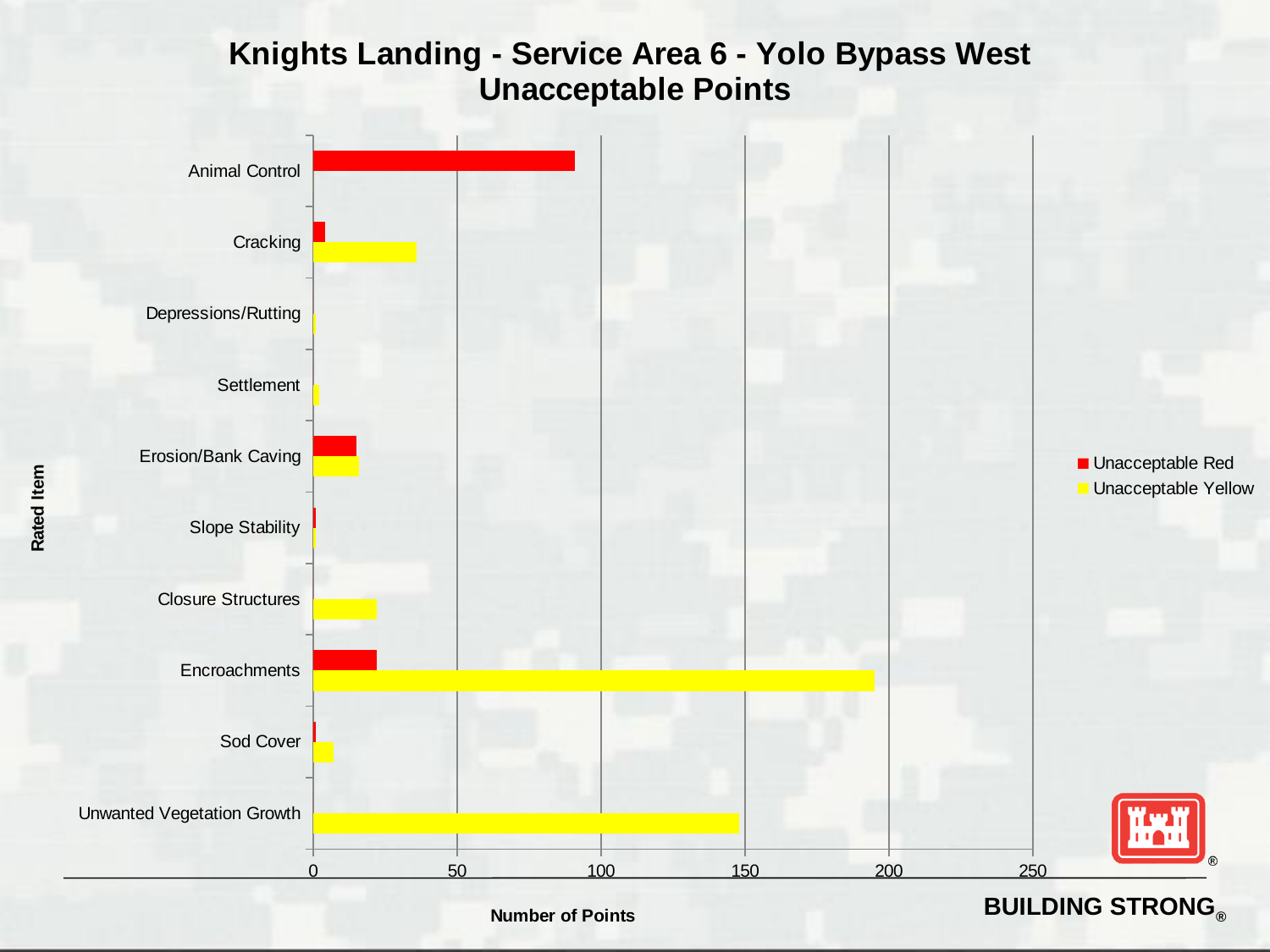
Which is larger: the Unacceptable Red value for Animal Control or for Encroachments? Animal Control What is the label of the horizontal axis? Number of Points Which is larger: the Unacceptable Yellow value for Encroachments or for Unwanted Vegetation Growth? Encroachments Is the Unacceptable Yellow value for Cracking greater or less than 50? less What kind of chart is shown on the slide? bar chart Which rated item has the highest Unacceptable Red value? Animal Control Which rated item has the highest Unacceptable Yellow value? Encroachments Is the Unacceptable Yellow value for Unwanted Vegetation Growth greater or less than 100? greater Is the Unacceptable Red value for Animal Control greater or less than 100? less How many series does the legend list? 2 How many rated items (categories) are listed on the vertical axis? 10